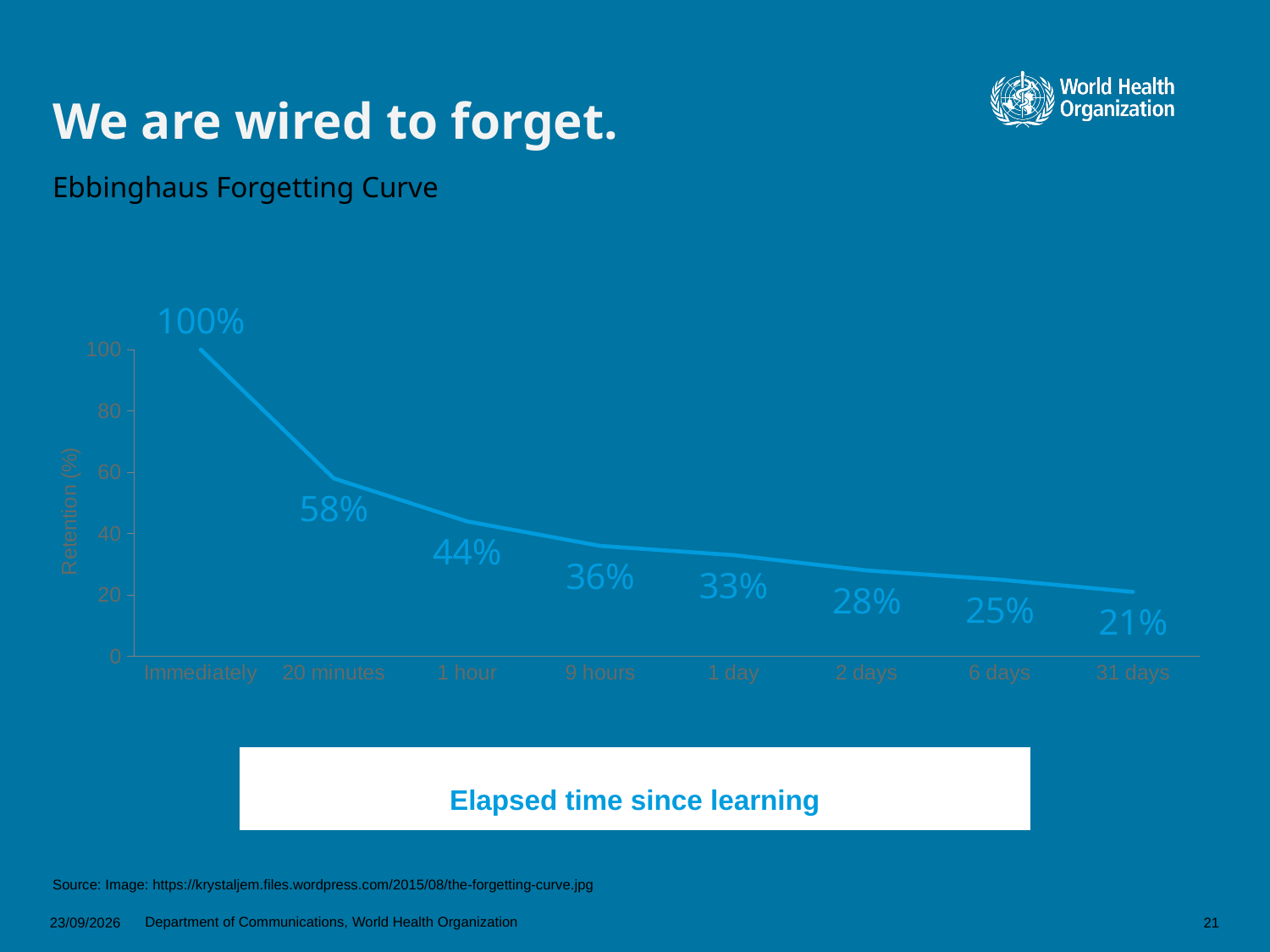
What is the retention value at 31 days? 21% How many time points are plotted on the x axis? 8 What is the label of the y axis? Retention (%) At which elapsed time is retention highest? Immediately What is the retention value at 1 day? 33% At which elapsed time is retention lowest? 31 days Do retention values rise or fall as elapsed time increases? fall Which has higher retention, 2 days or 6 days? 2 days What is the difference in retention between 1 hour and 9 hours? 8% What is the difference in retention between Immediately and 20 minutes? 42% What is the retention value at 20 minutes? 58% What type of chart is shown on the slide? line chart